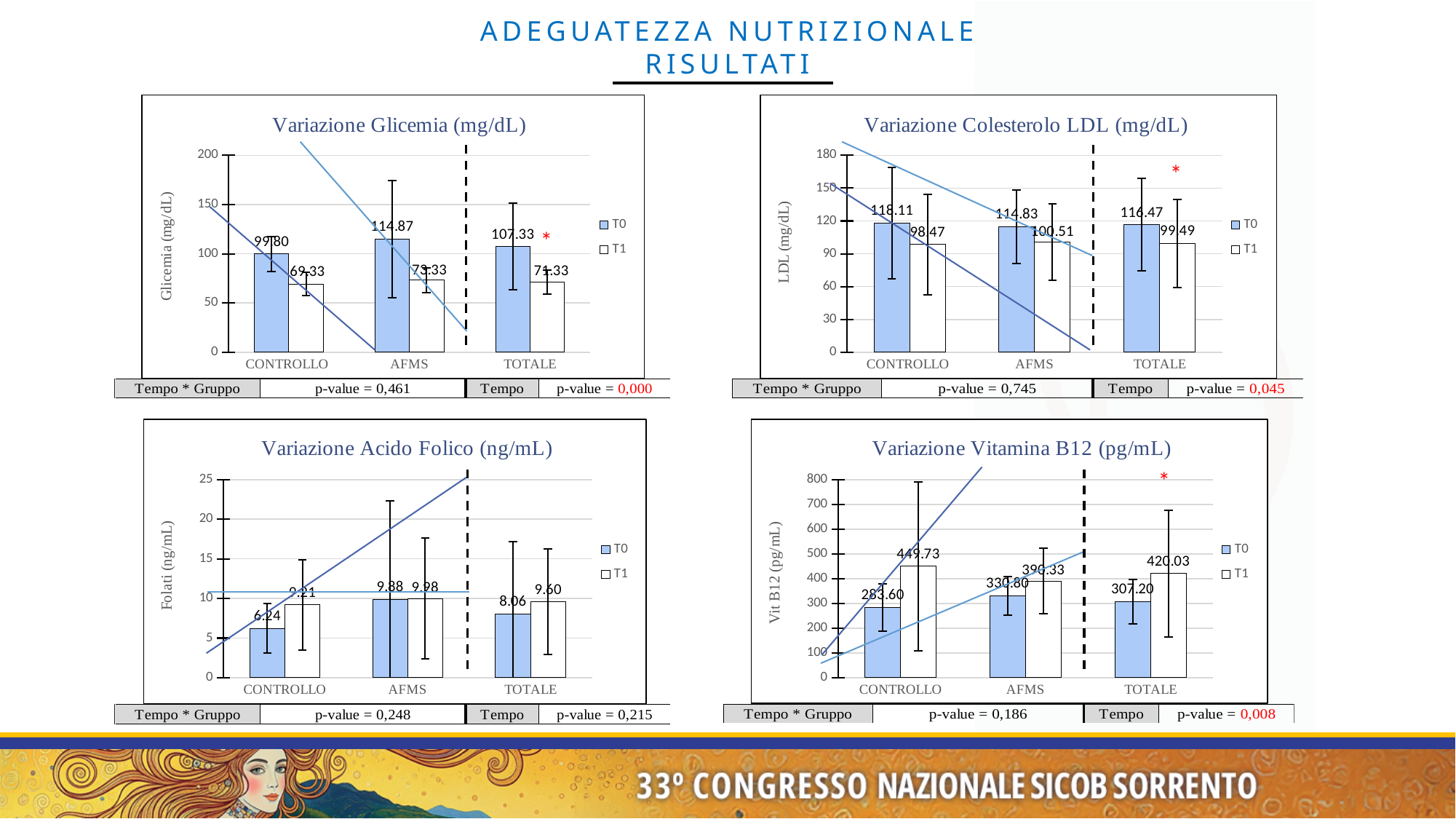
In the 'Variazione Vitamina B12 (pg/mL)' chart, which is larger for TOTALE, the T0 or the T1 value? T1 In the 'Variazione Vitamina B12 (pg/mL)' chart, is the T1 value for AFMS greater or less than 300? greater In the 'Variazione Colesterolo LDL (mg/dL)' chart, what is the difference between the T0 and T1 values for TOTALE? 16.98 In the 'Variazione Glicemia (mg/dL)' chart, what is the T1 value for CONTROLLO? 69.33 In the 'Variazione Acido Folico (ng/mL)' chart, what is the T0 value for CONTROLLO? 6.24 In the 'Variazione Glicemia (mg/dL)' chart, what is the T0 value for AFMS? 114.87 How many series does the legend of the 'Variazione Glicemia (mg/dL)' chart list? 2 In the 'Variazione Acido Folico (ng/mL)' chart, which category has the lowest T0 value? CONTROLLO In the 'Variazione Colesterolo LDL (mg/dL)' chart, what is the T0 value for CONTROLLO? 118.11 In the 'Variazione Glicemia (mg/dL)' chart, what is the difference between the T0 values for AFMS and TOTALE? 7.54 In the 'Variazione Vitamina B12 (pg/mL)' chart, what is the T1 value for CONTROLLO? 449.73 What kind of chart is the 'Variazione Colesterolo LDL (mg/dL)' chart? bar chart